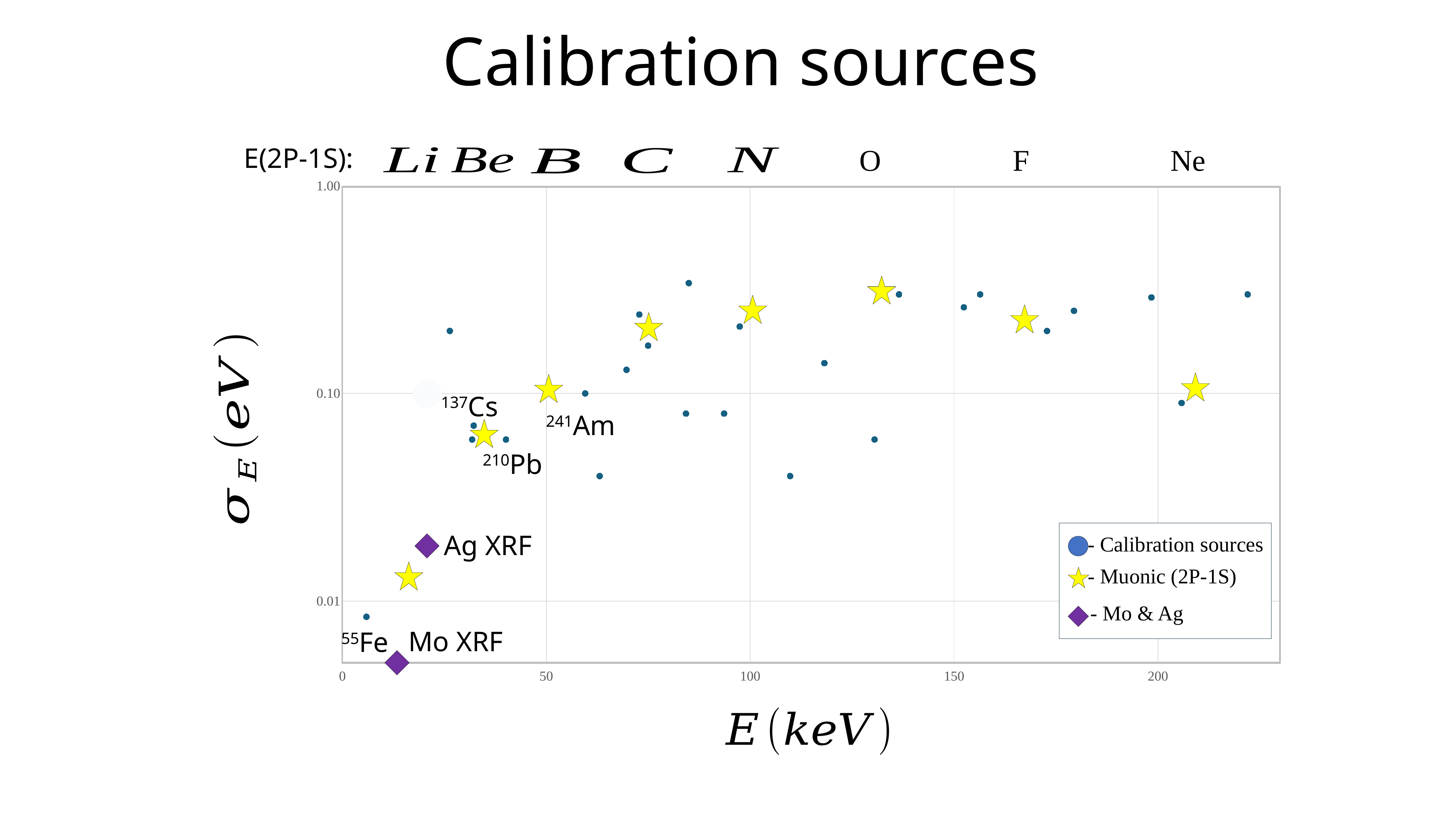
How many purple diamond (Mo & Ag) points are plotted? 2 Which muonic (2P-1S) element has the highest σ_E value? O Is the value for Ag XRF greater or less than 0.01 eV? greater Is the value for 137Cs greater or less than 0.10 eV? less Is the value for Mo XRF greater or less than 0.01 eV? less What is the title of the slide's chart? Calibration sources How many yellow star (Muonic 2P-1S) points are plotted? 8 What kind of chart is shown on the slide? scatter plot Which marker shape does the legend use for the Muonic (2P-1S) series? yellow star Which muonic (2P-1S) element has the lowest σ_E value? Li Which has the higher σ_E value, Ag XRF or Mo XRF? Ag XRF How many series does the legend list? 3